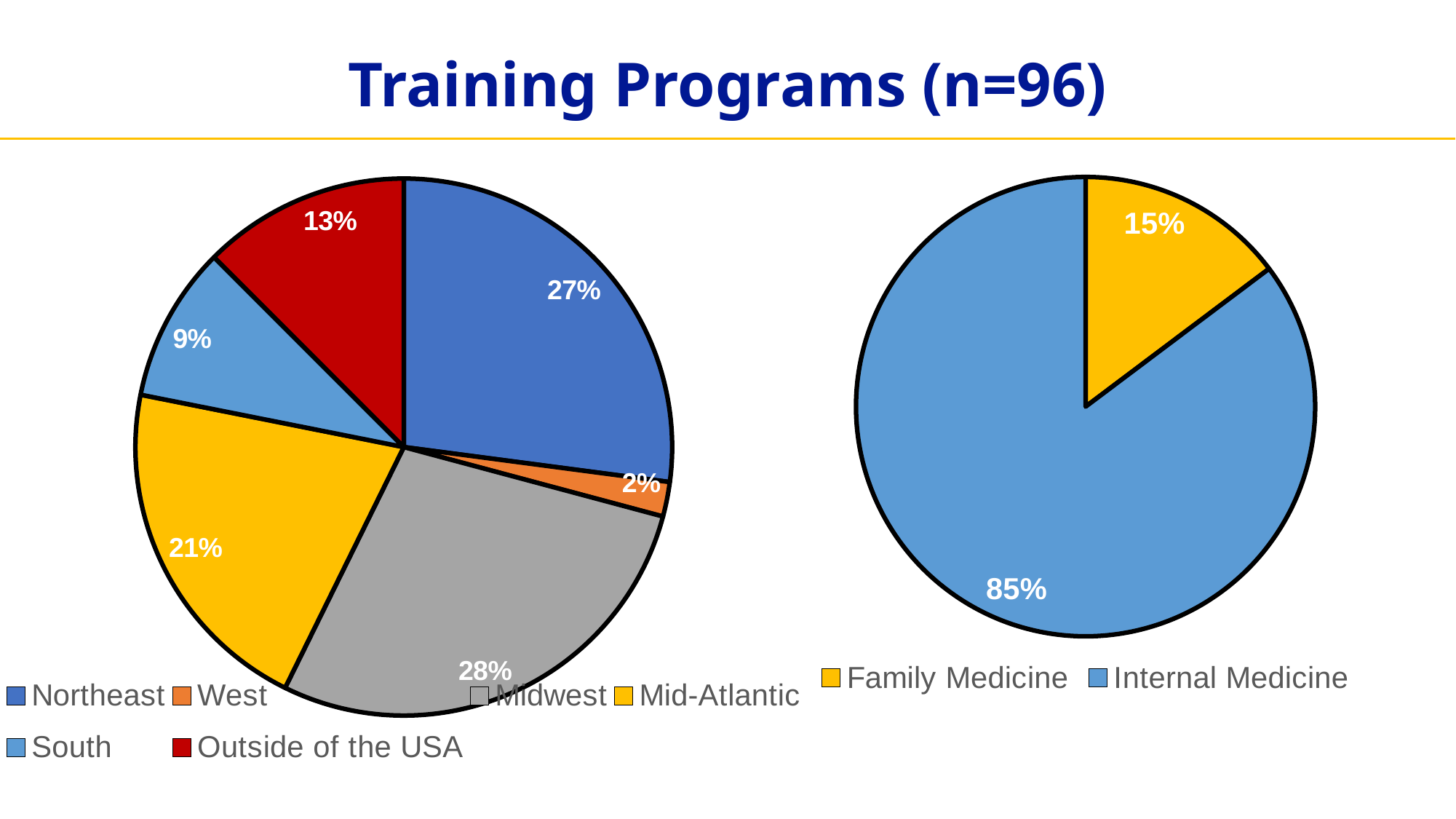
In the left pie chart, what is the difference between the Mid-Atlantic and South percentages? 12% In the right pie chart, what percentage is shown for Family Medicine? 15% What type of chart is the right chart? Pie chart In the right pie chart, what percentage is shown for Internal Medicine? 85% In the left pie chart, which region has the smallest slice? West What is the title of the slide? Training Programs (n=96) How many slices does the left pie chart have? 6 In the left pie chart, what percentage is shown for the Midwest slice? 28% In the left pie chart, which is larger, the South slice or the Outside of the USA slice? Outside of the USA In the left pie chart, what percentage is shown for Outside of the USA? 13% In the left pie chart, what percentage is shown for the Northeast slice? 27% In the left pie chart, which region has the largest slice? Midwest